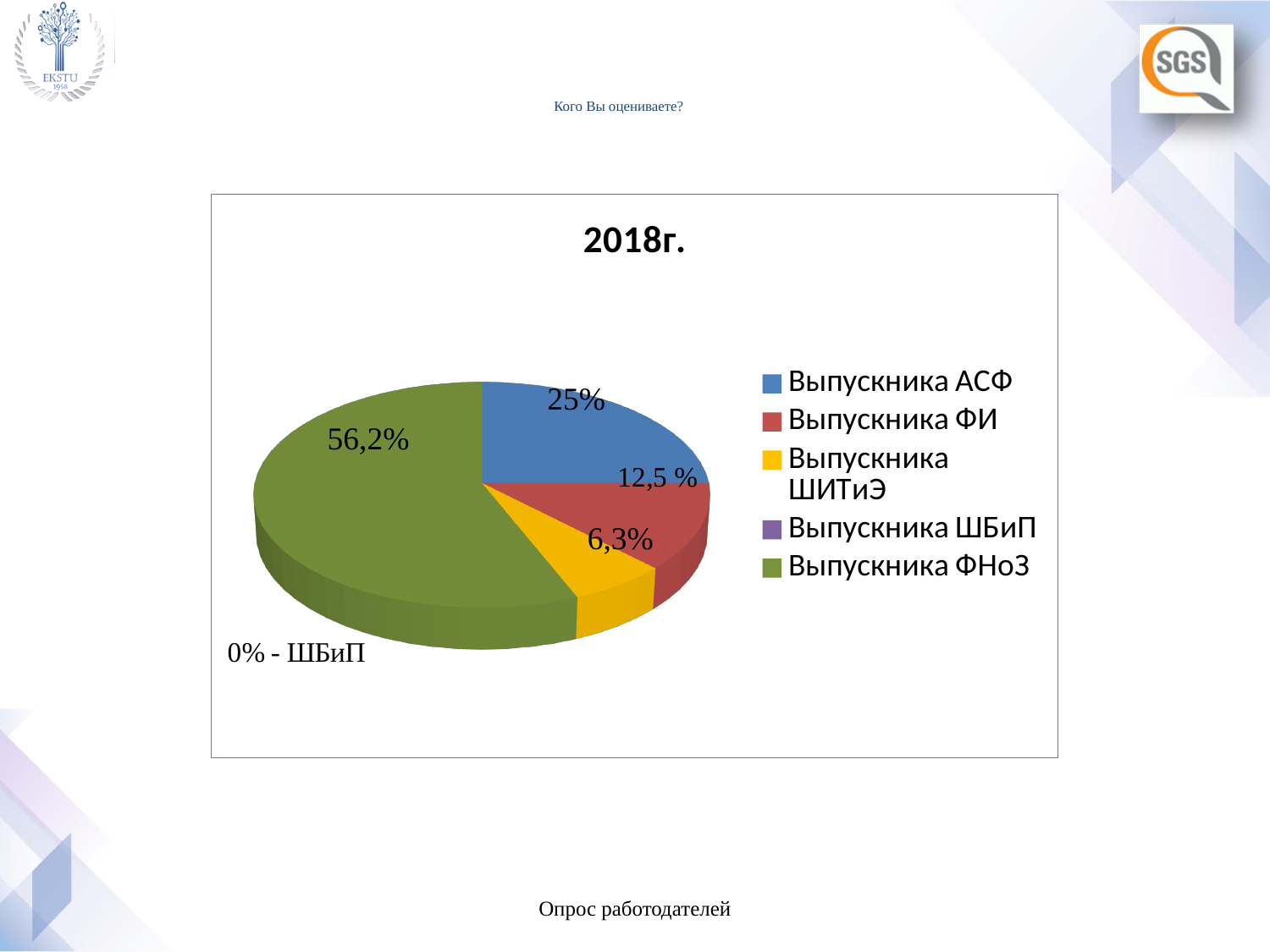
What share of the pie is labelled for Выпускника ФИ? 12,5 % What share of the pie is labelled for Выпускника ФНоЗ? 56,2% Which category has the smallest share in the chart? Выпускника ШБиП What share is given for ШБиП on the chart? 0% What share of the pie is labelled for Выпускника ШИТиЭ? 6,3% What is the title of the chart? 2018г. What share of the pie is labelled for Выпускника АСФ? 25% What kind of chart is shown on the slide? pie chart What colour is the slice for Выпускника ФНоЗ? green How many entries does the chart legend list? 5 Which is larger, the share for Выпускника АСФ or for Выпускника ФИ? Выпускника АСФ Which category has the largest slice of the pie? Выпускника ФНоЗ